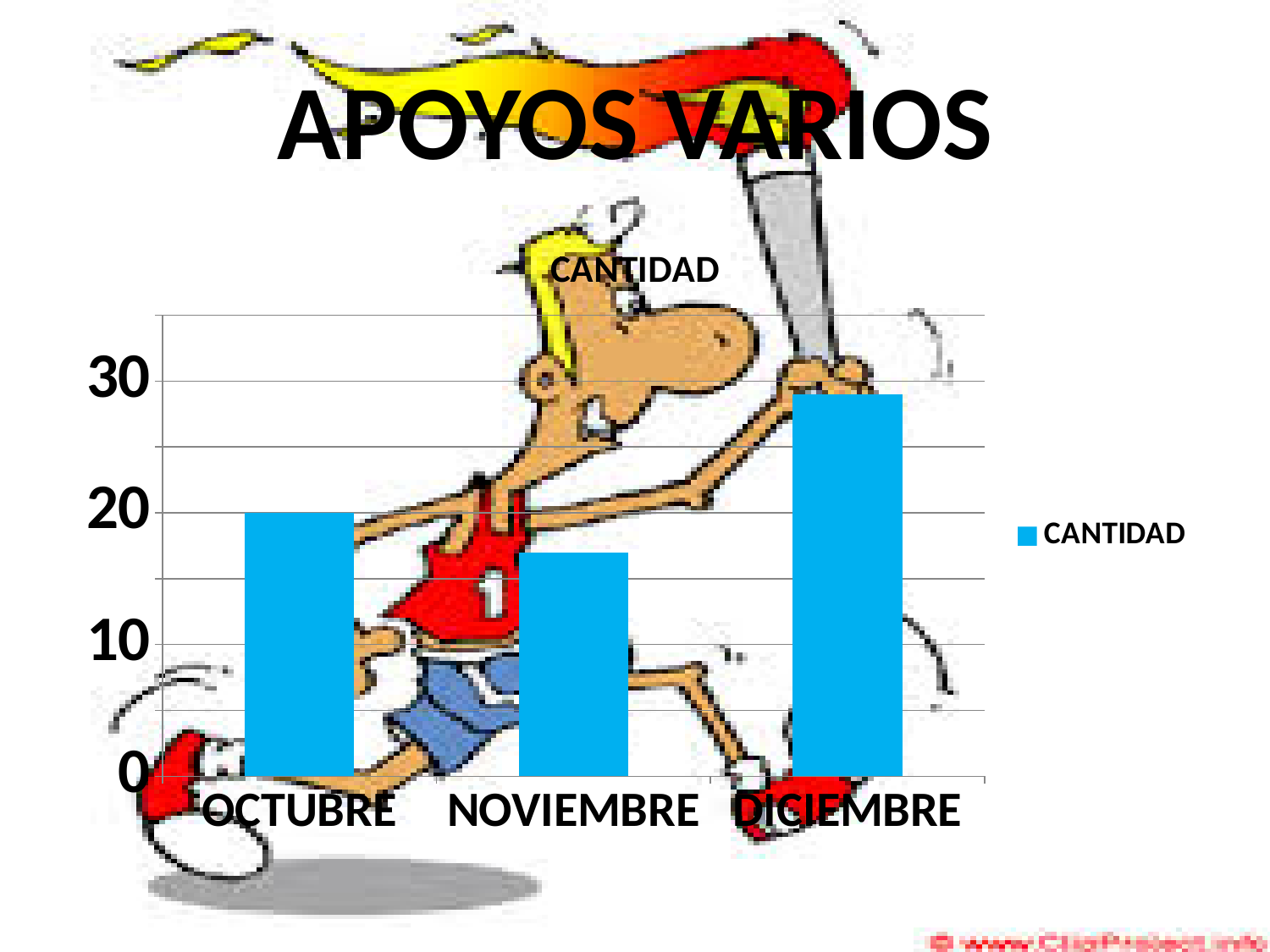
Does the value rise or fall from NOVIEMBRE to DICIEMBRE? rise Which is larger, the value for OCTUBRE or the value for NOVIEMBRE? OCTUBRE How many categories are shown on the x axis of the chart? 3 What is the title of the chart? CANTIDAD What is the value for OCTUBRE? 20 What kind of chart is shown on the slide? bar chart Is the value for NOVIEMBRE greater or less than 20? less Is the value for DICIEMBRE greater or less than 20? greater How many series does the chart's legend list? 1 Which month has the highest value in the chart? DICIEMBRE Which month has the lowest value in the chart? NOVIEMBRE